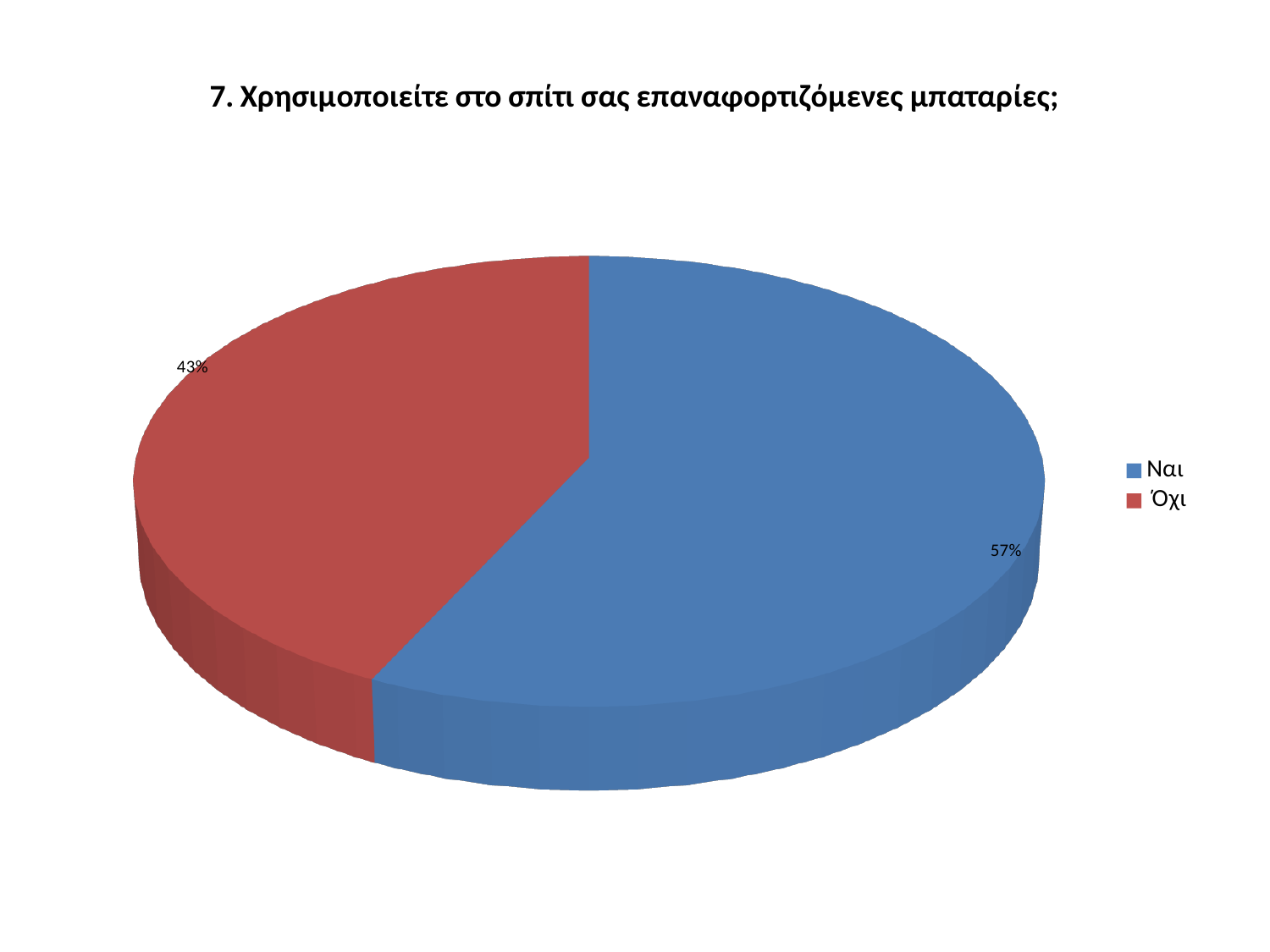
What is the difference in percentage points between the Ναι and Όχι slices? 14 Which slice is larger, Ναι or Όχι? Ναι How many slices does the pie chart have? 2 What colour is the Όχι slice? red What share of the pie does Όχι represent? 43% What kind of chart is shown on the slide? pie chart How many entries does the legend list? 2 Which category has the largest slice of the pie? Ναι What is the title of the chart? 7. Χρησιμοποιείτε στο σπίτι σας επαναφορτιζόμενες μπαταρίες; Is the share for Ναι greater or less than 50%? greater What share of the pie does Ναι represent? 57% Which category has the smallest slice of the pie? Όχι